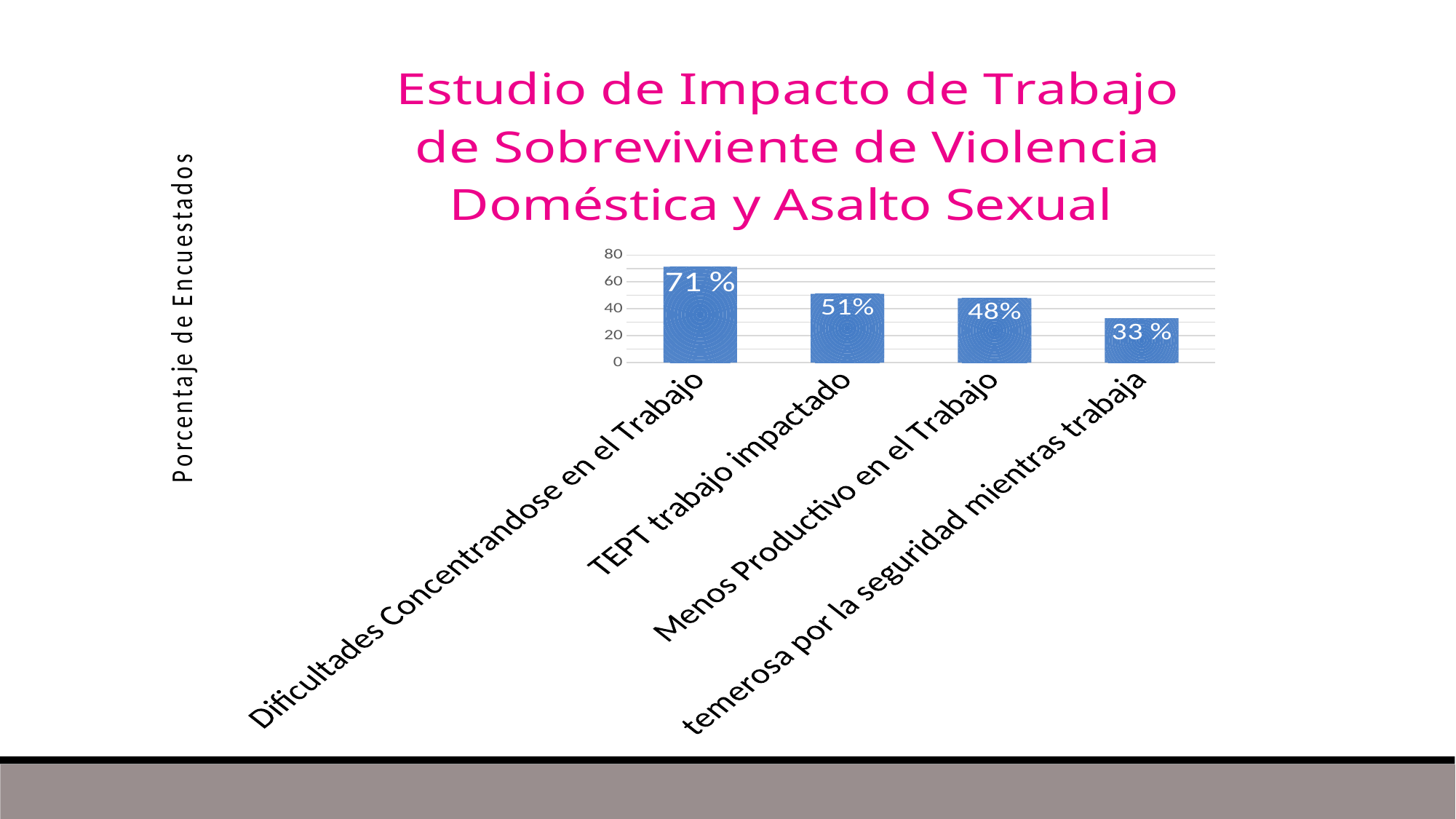
What is the value for 'TEPT trabajo impactado'? 51% What is the difference between the values for 'TEPT trabajo impactado' and 'Menos Productivo en el Trabajo'? 3% How many categories are shown in the chart? 4 What kind of chart is shown on the slide? Bar chart Which category has the lowest value? temerosa por la seguridad mientras trabaja What is the label of the vertical axis? Porcentaje de Encuestados What is the value for 'Dificultades Concentrandose en el Trabajo'? 71 % Which is larger, the value for 'TEPT trabajo impactado' or the value for 'temerosa por la seguridad mientras trabaja'? TEPT trabajo impactado Which category has the highest value? Dificultades Concentrandose en el Trabajo What is the difference between the values for 'Dificultades Concentrandose en el Trabajo' and 'temerosa por la seguridad mientras trabaja'? 38% What is the value for 'Menos Productivo en el Trabajo'? 48% What is the value for 'temerosa por la seguridad mientras trabaja'? 33 %